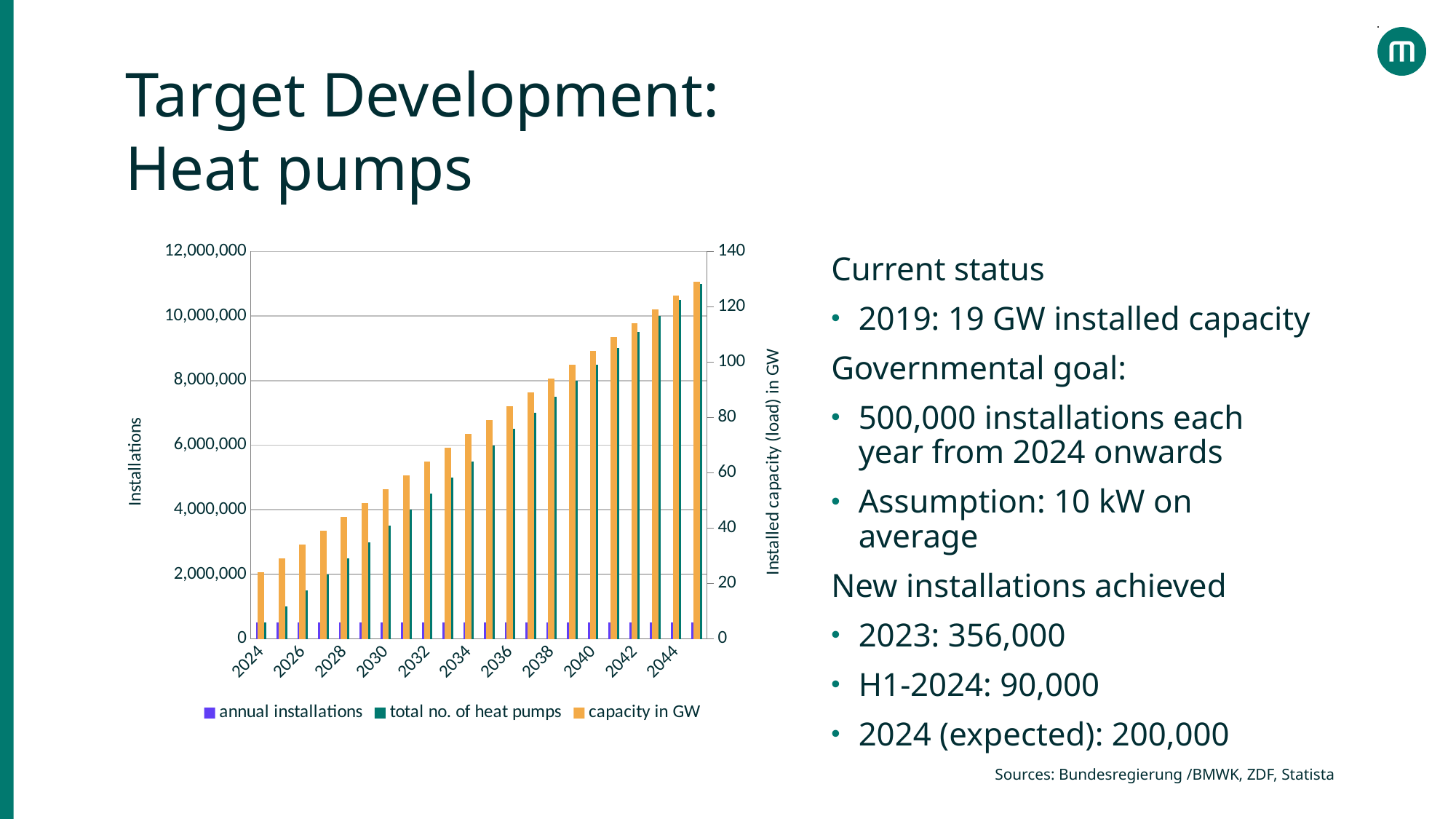
Is the capacity in GW in 2044 greater or less than 120? greater Does the capacity in GW rise or fall from 2024 to 2044? rise Is the total no. of heat pumps in 2030 greater or less than 4,000,000? less Which series is shown in orange in the chart? capacity in GW How many series does the chart legend list? 3 Is the total no. of heat pumps in 2040 greater or less than 8,000,000? greater In 2036, which is larger: annual installations or total no. of heat pumps? total no. of heat pumps What is the title of the left vertical axis of the chart? Installations Which series has the tallest bars in the chart? capacity in GW What kind of chart is shown on the slide? bar chart